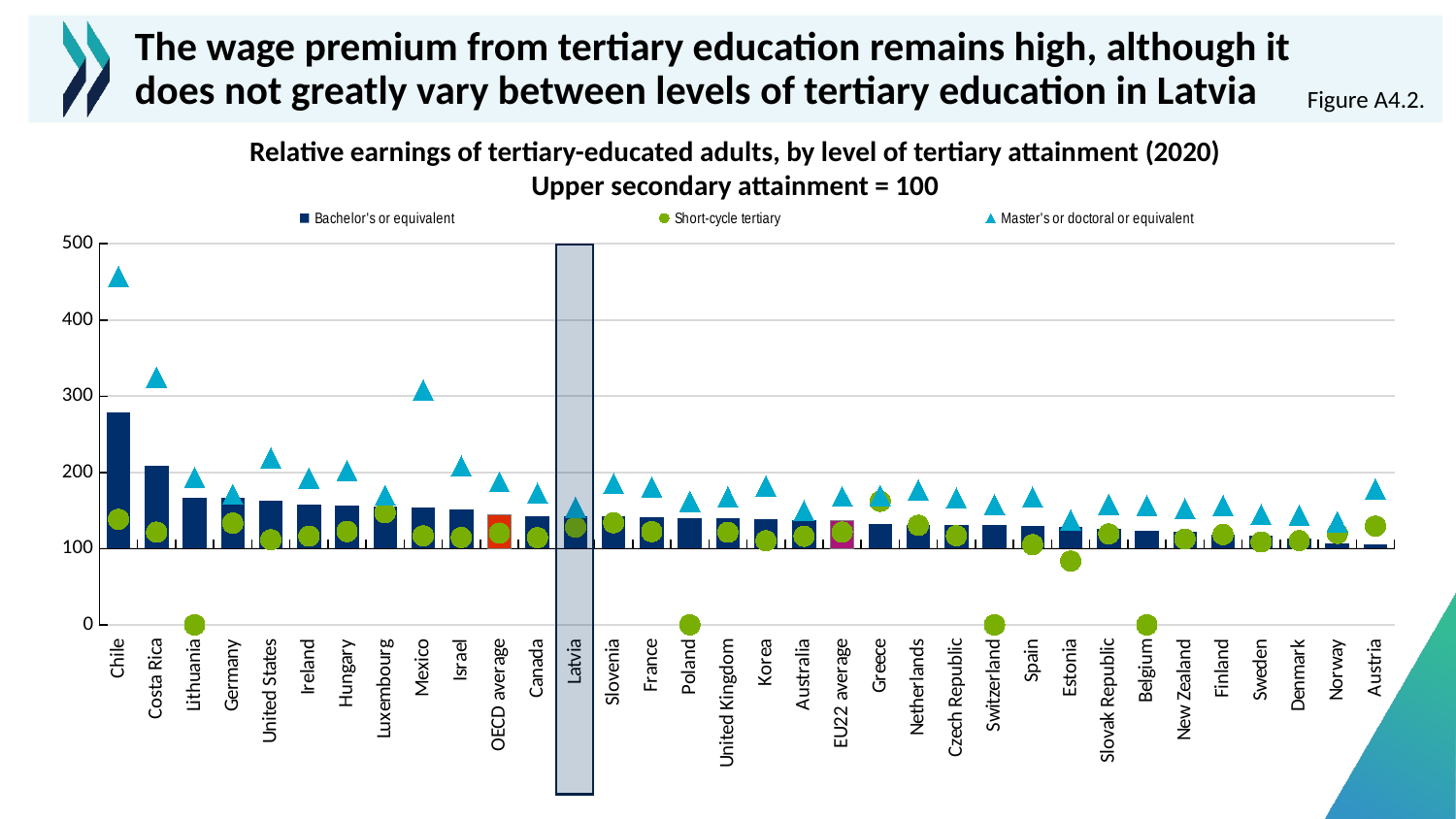
Which country is highlighted with a shaded box on the chart? Latvia Do the Bachelor's or equivalent bars generally rise or fall from left to right along the x axis? fall Is the Bachelor's or equivalent value for Austria greater or less than 200? less Which country has the highest value for Bachelor's or equivalent? Chile How many countries or averages are shown along the x axis? 34 Is the Bachelor's or equivalent value for Chile greater or less than 200? greater Which country has the highest value for Master's or doctoral or equivalent? Chile How many series does the legend list? 3 Which is larger, the Bachelor's or equivalent value for Chile or for Costa Rica? Chile What kind of chart is shown on the slide? A bar chart combined with point markers Is the Master's or doctoral or equivalent value for Chile greater or less than 400? greater